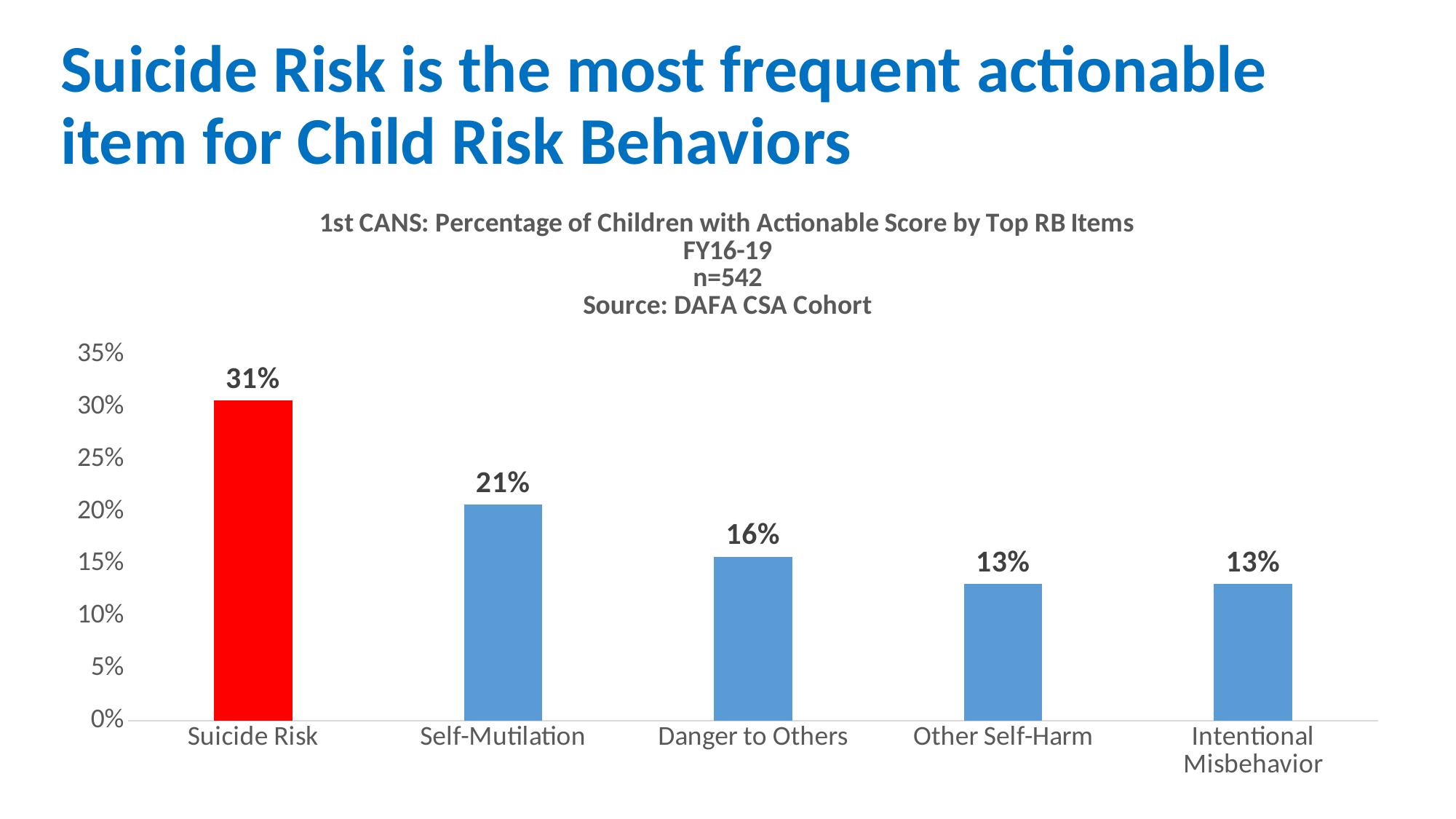
What is the difference between the values for Suicide Risk and Self-Mutilation? 10% What is the value for Suicide Risk? 31% What kind of chart is shown on the slide? bar chart How many categories are shown on the x axis? 5 Which is larger, the value for Danger to Others or the value for Intentional Misbehavior? Danger to Others What is the value for Danger to Others? 16% Which bar is coloured red? Suicide Risk What is the difference between the values for Self-Mutilation and Danger to Others? 5% What is the value for Other Self-Harm? 13% What is the value for Self-Mutilation? 21% Which category has the highest value? Suicide Risk Is the value for Suicide Risk greater or less than 30%? greater